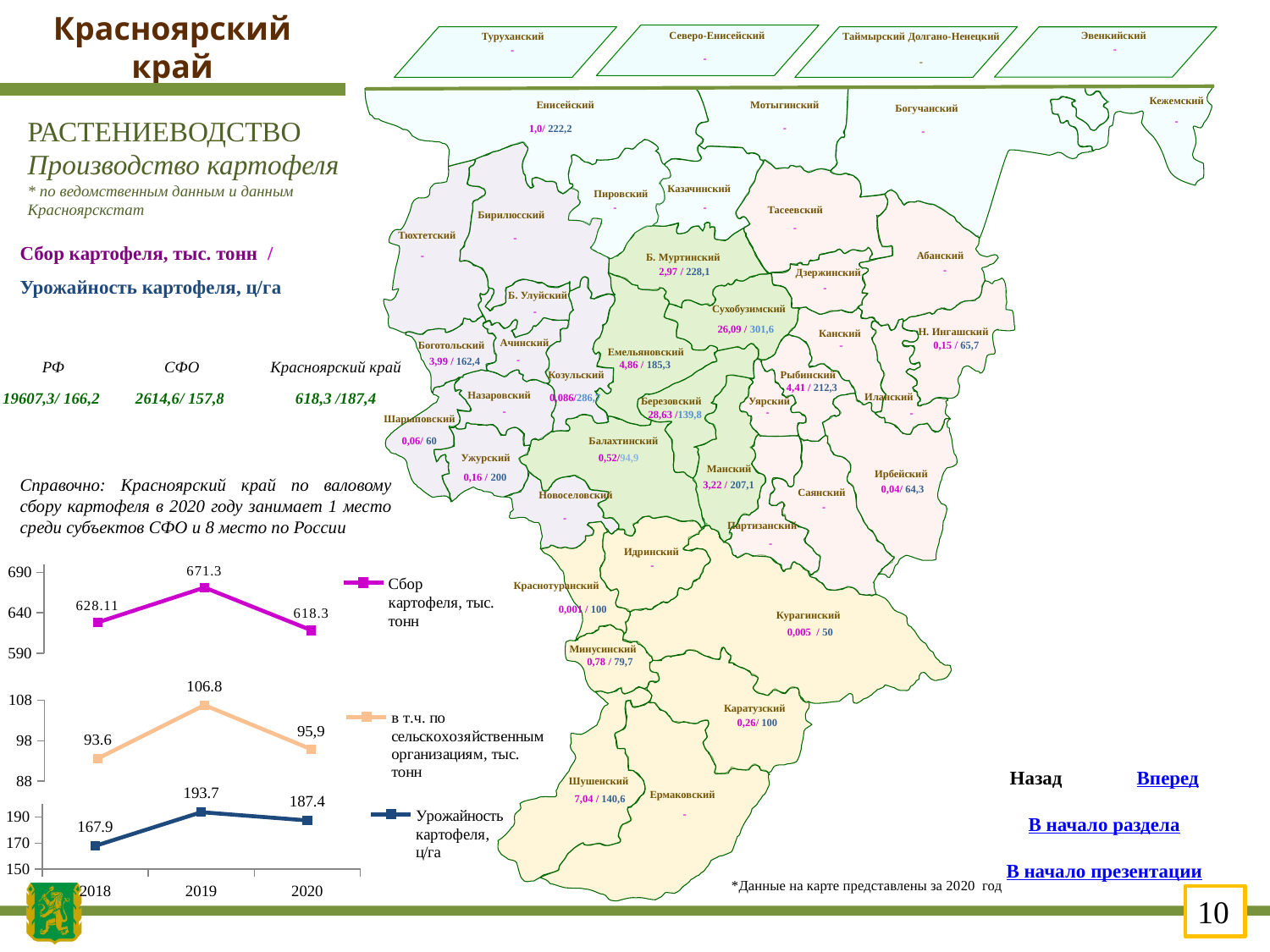
In the line chart for 'Сбор картофеля, тыс. тонн', does the value rise or fall from 2019 to 2020? Fall In the line chart for 'в т.ч. по сельскохозяйственным организациям, тыс. тонн', what is the difference between the 2019 and 2018 values? 13.2 In the line chart for 'Урожайность картофеля, ц/га', by how much did the value increase from 2018 to 2019? 25.8 How many years are plotted on the x axis of the line charts at the bottom left of the slide? 3 In the line chart for 'Урожайность картофеля, ц/га', which year has the lowest value? 2018 In the line chart for 'в т.ч. по сельскохозяйственным организациям, тыс. тонн', what is the value for 2020? 95,9 What kind of chart is used at the bottom left of the slide to show 'Сбор картофеля, тыс. тонн'? Line chart In the line chart for 'Сбор картофеля, тыс. тонн', what is the value for 2019? 671.3 In the line chart for 'Сбор картофеля, тыс. тонн', which year has the highest value? 2019 In the line chart for 'Урожайность картофеля, ц/га', what is the value for 2018? 167.9 In the line chart for 'Сбор картофеля, тыс. тонн', what is the difference between the 2019 and 2020 values? 53 In the line chart for 'в т.ч. по сельскохозяйственным организациям, тыс. тонн', which year has the larger value, 2018 or 2020? 2020